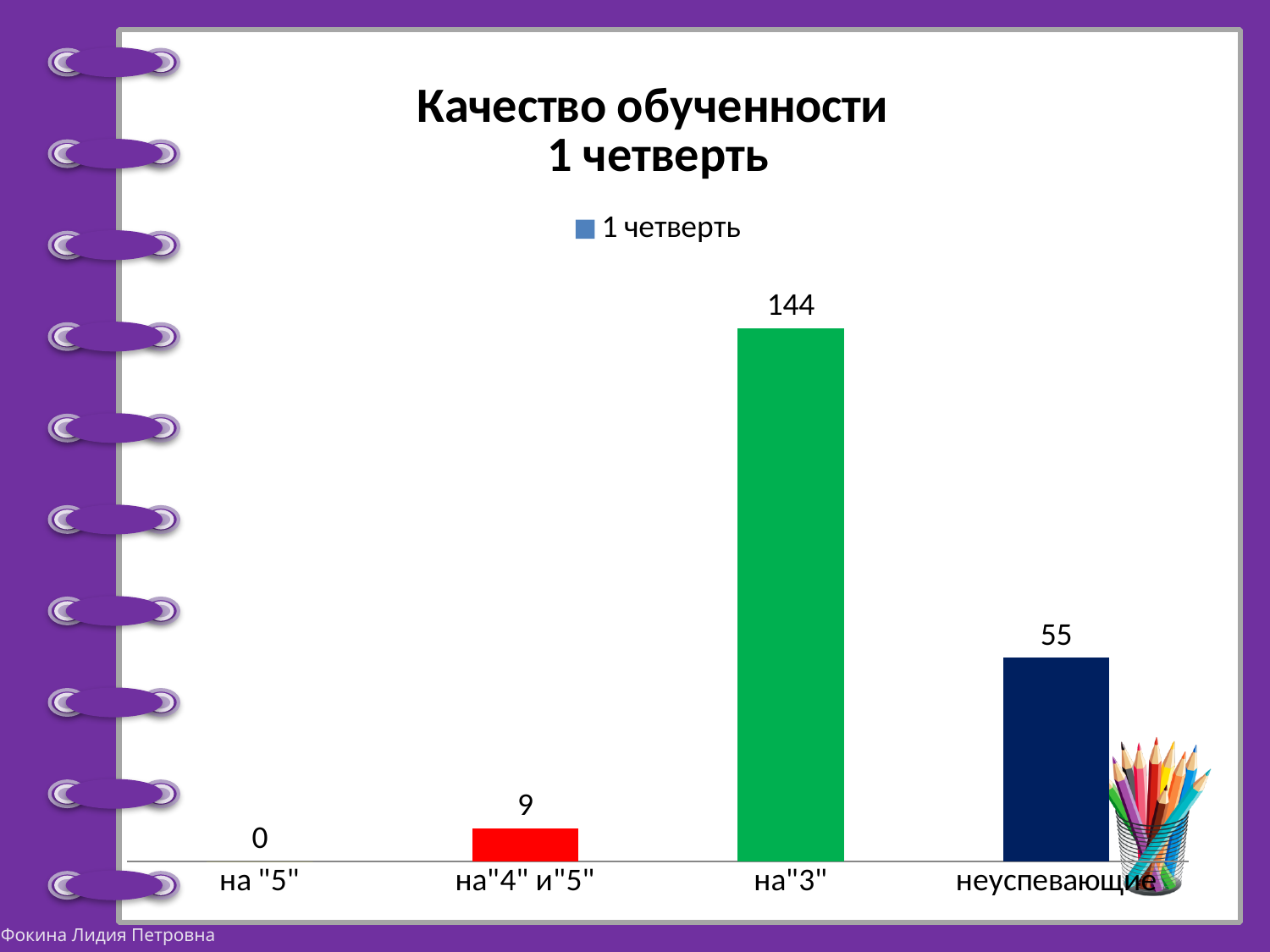
Which is larger, the value for неуспевающие or the value for на"4" и"5"? неуспевающие What is the title of the chart? Качество обученности 1 четверть What is the value for на"3"? 144 How many series does the legend list? 1 Which category has the lowest value? на "5" What is the difference between the values for на"3" and неуспевающие? 89 How many categories are shown on the x axis? 4 What is the value for на"4" и"5"? 9 What is the value for неуспевающие? 55 Which category has the highest value? на"3" What kind of chart is shown on the slide? bar chart What is the value for на "5"? 0